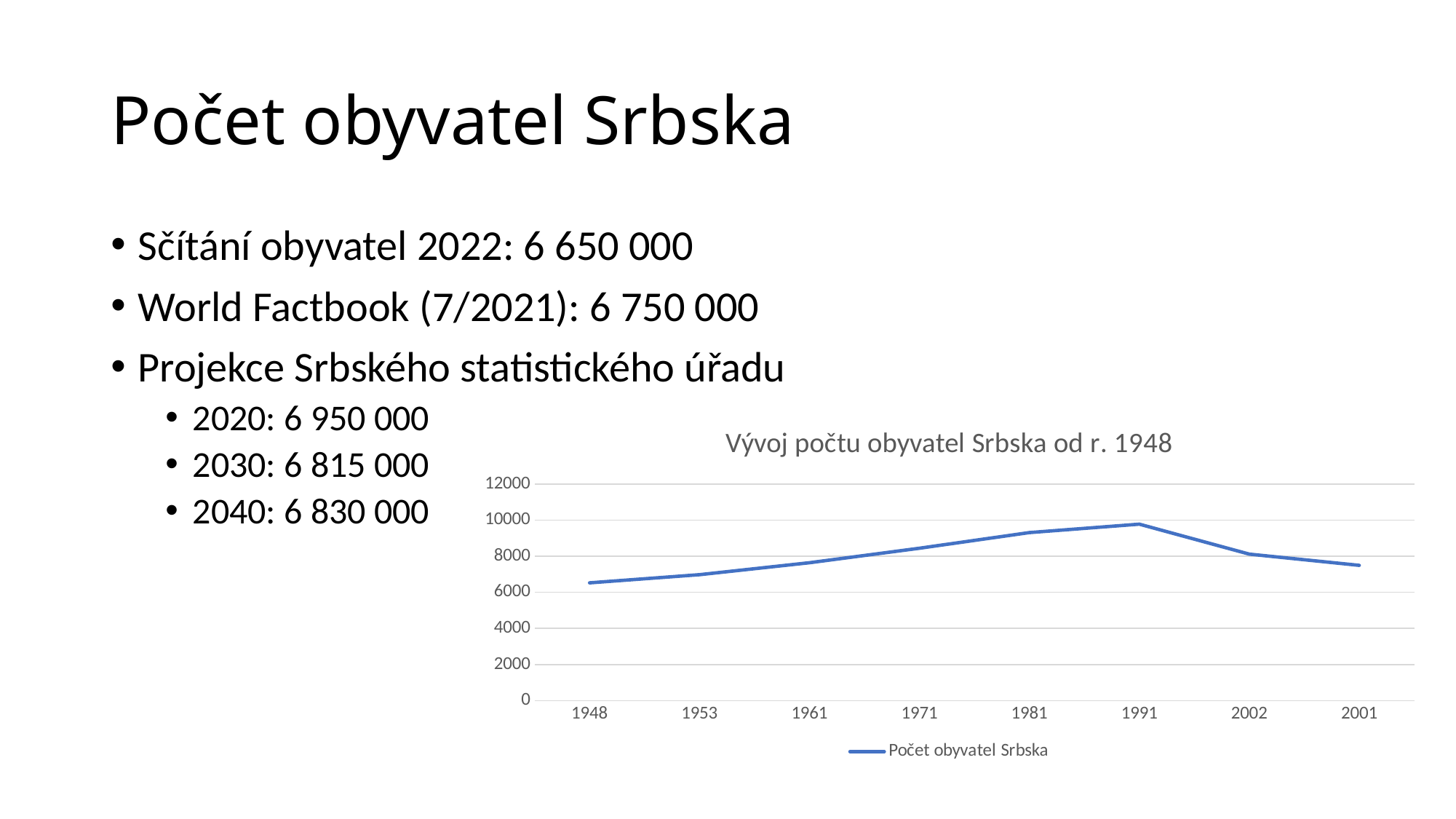
Which is larger, the value for 1981 or the value for 1953? 1981 How do the values change along the x axis from 1948 to 1991? they rise How many points are plotted along the x axis of the chart? 8 Is the value for 1991 greater or less than 8000? greater Which year has the highest value in the chart? 1991 Is the value for 2001 greater or less than 8000? less What is the title of the chart? Vývoj počtu obyvatel Srbska od r. 1948 How many series does the chart legend list? 1 Which year has the lowest value in the chart? 1948 What is the name of the series shown in the chart legend? Počet obyvatel Srbska Is the value for 1948 greater or less than 8000? less What kind of chart is shown on the slide? line chart